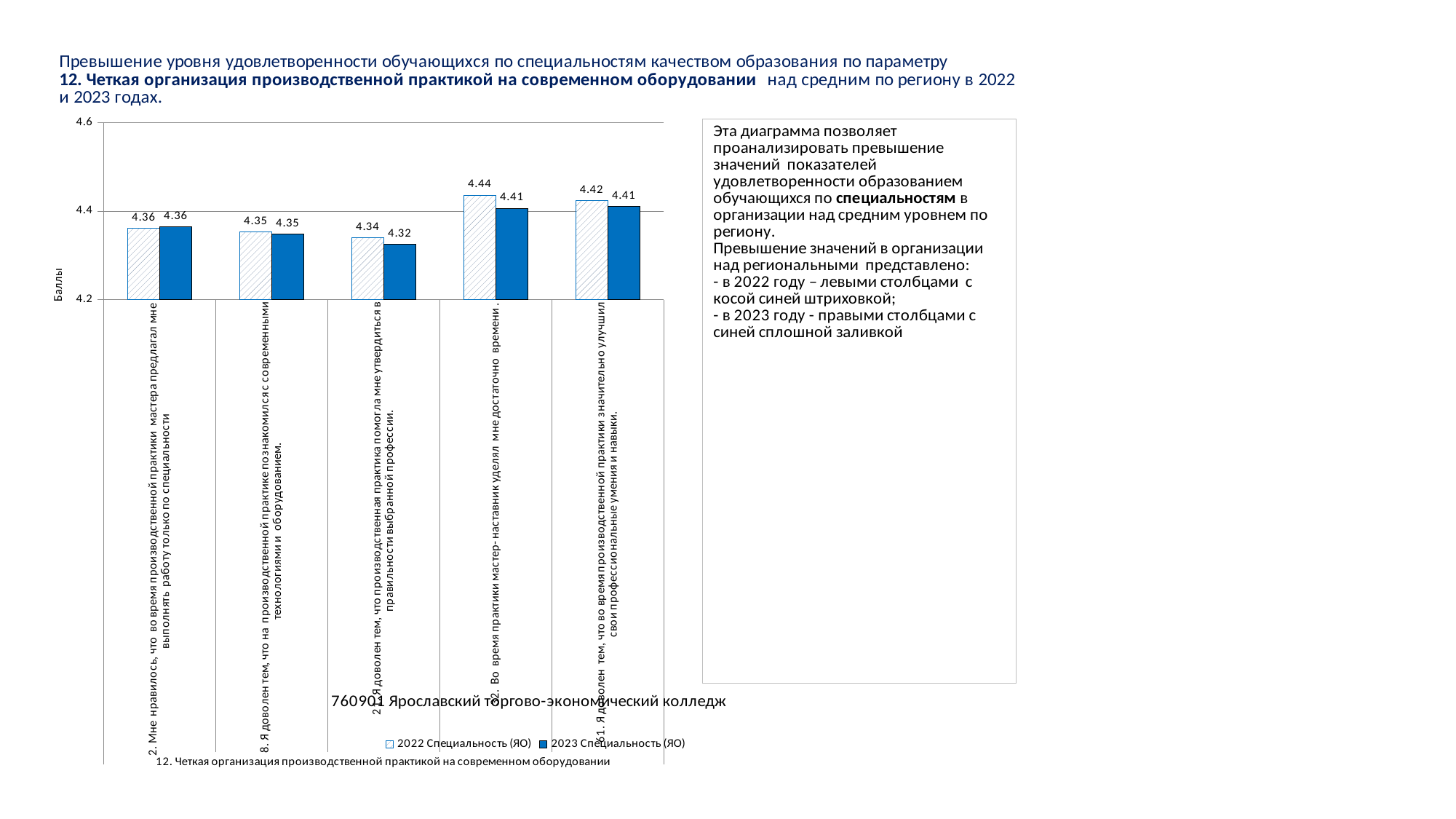
How many categories (statements) are plotted on the chart? 5 What is the label of the vertical axis of the chart? Баллы Which statement has the highest 2022 Специальность (ЯО) value? Во время практики мастер-наставник уделял мне достаточно времени How many series does the chart legend list? 2 What kind of chart is shown on the slide? bar chart Which is larger: the 2022 value for statement 31 (improved professional skills) or the 2022 value for statement 8 (modern technologies and equipment)? statement 31 (4.42) For statement 8 about getting acquainted with modern technologies and equipment, is the 2022 value greater or less than 4.4? less What is the 2023 Специальность (ЯО) value for the statement "Я доволен тем, что производственная практика помогла мне утвердиться в правильности выбранной профессии"? 4.32 What is the difference between the 2022 and 2023 values for the statement "Во время практики мастер-наставник уделял мне достаточно времени"? 0.03 Which statement has the lowest 2023 Специальность (ЯО) value? Я доволен тем, что производственная практика помогла мне утвердиться в правильности выбранной профессии What is the 2022 Специальность (ЯО) value for statement 31 about significantly improving professional skills during practice? 4.42 What is the 2022 Специальность (ЯО) value for the statement "Во время практики мастер-наставник уделял мне достаточно времени"? 4.44